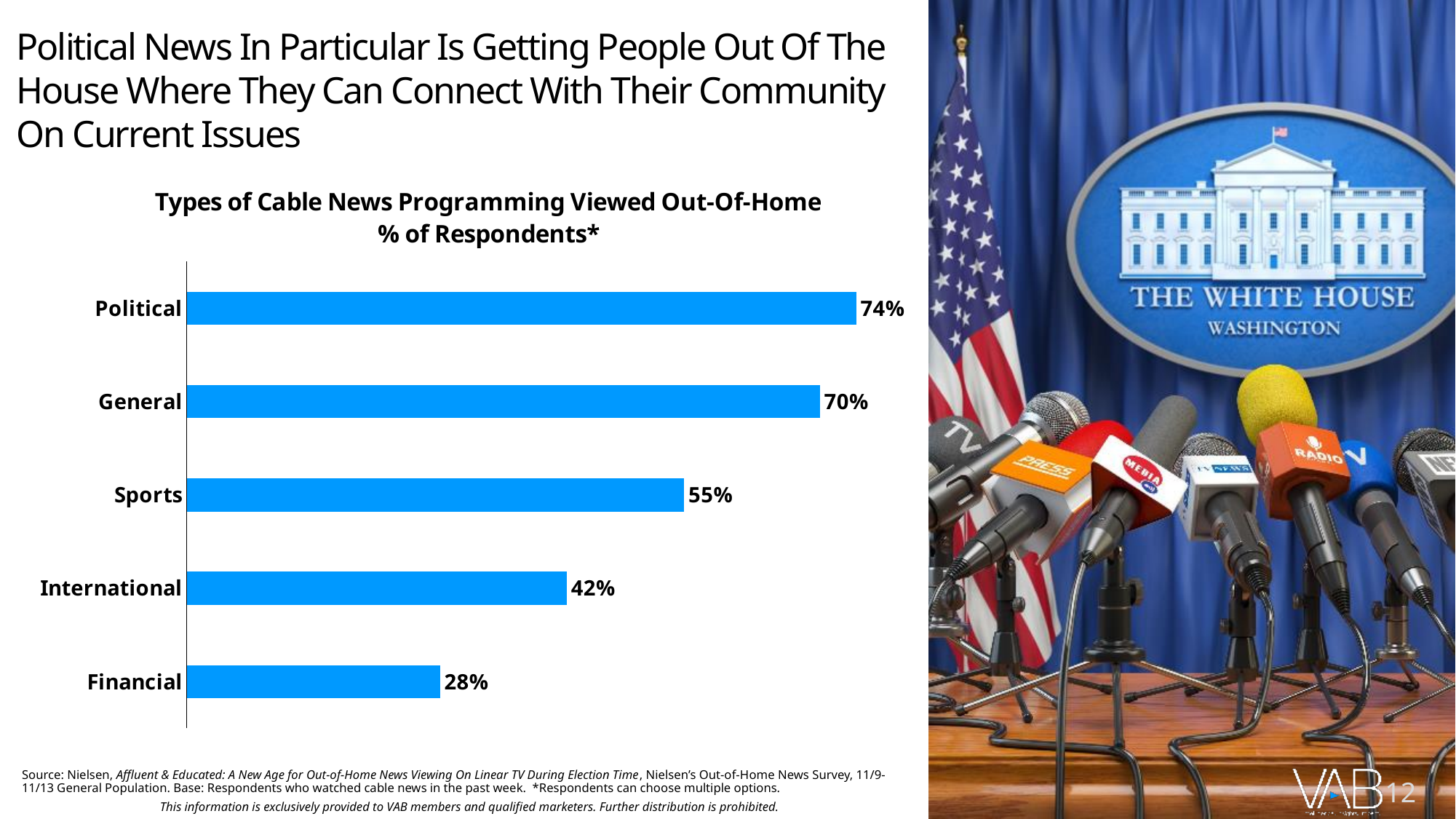
What is the difference between the values for Sports and International? 13% Which type of cable news programming has the highest percentage of respondents? Political What is the value shown for Financial? 28% What percentage of respondents viewed Political cable news programming out-of-home? 74% What colour are the bars in the chart? Blue What is the value shown for Sports? 55% What is the difference between the values for Political and General? 4% How many types of cable news programming are shown in the chart? 5 What is the title of the chart? Types of Cable News Programming Viewed Out-Of-Home % of Respondents* Which is larger, the value for International or the value for Financial? International Which type of cable news programming has the lowest percentage of respondents? Financial What kind of chart is shown on the slide? Bar chart